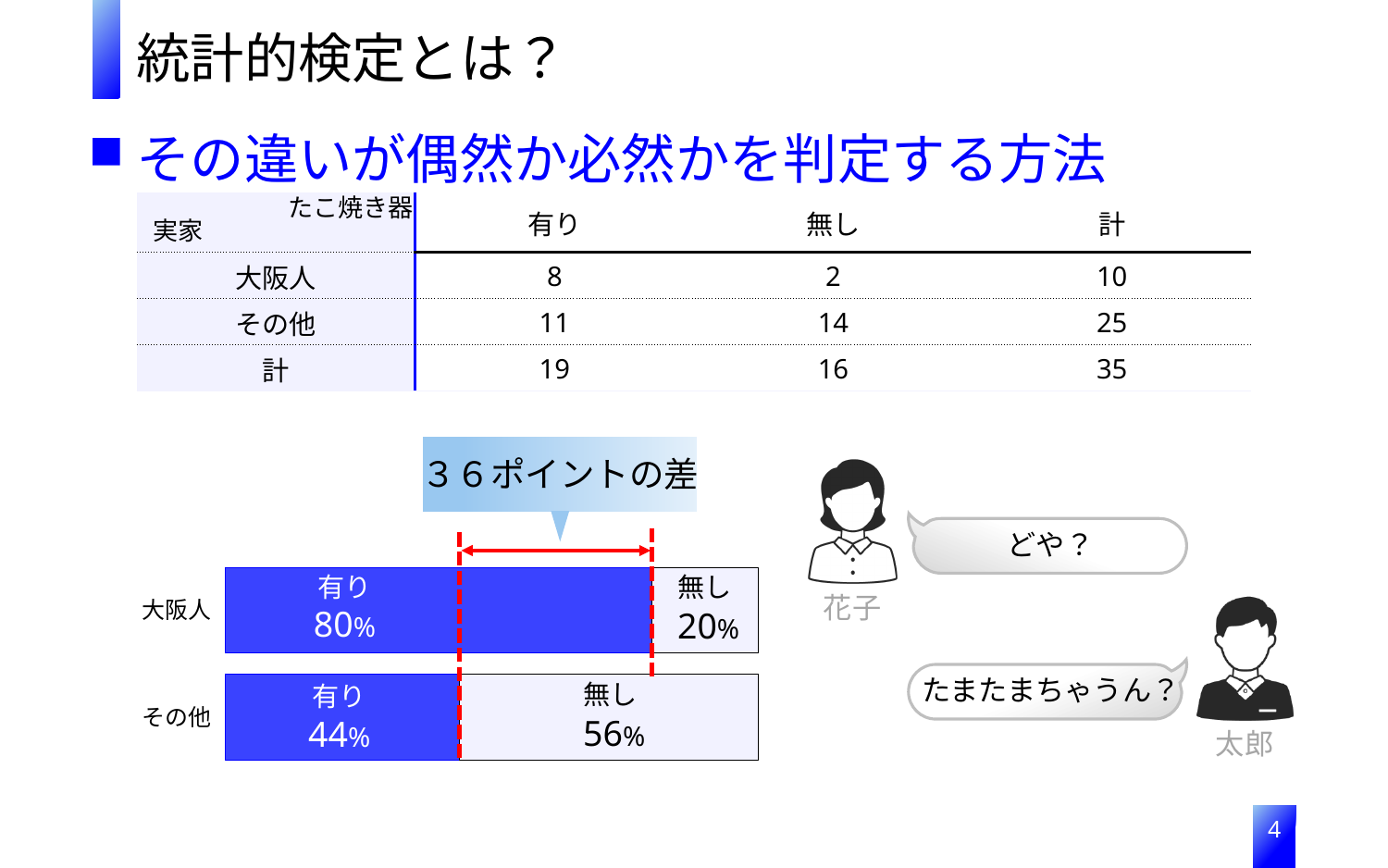
In the bar chart, what is the difference between the 有り share for 大阪人 and the 有り share for その他? 36 percentage points In the bar chart, what is the 有り value for その他? 44% In the bar chart, what is the 無し value for その他? 56% How many categories (bars) does the bar chart show? 2 What kind of chart is shown on the slide? bar chart In the bar chart, which category has the higher 無し share? その他 In the bar chart, what is the difference between the 無し share for その他 and the 無し share for 大阪人? 36 percentage points In the bar chart, what is the total of the 有り and 無し segments for 大阪人? 100% What does the callout above the bar chart say? ３６ポイントの差 In the bar chart, what is the 有り value for 大阪人? 80% In the bar chart, what is the 無し value for 大阪人? 20% In the bar chart, which category has the higher 有り share, 大阪人 or その他? 大阪人